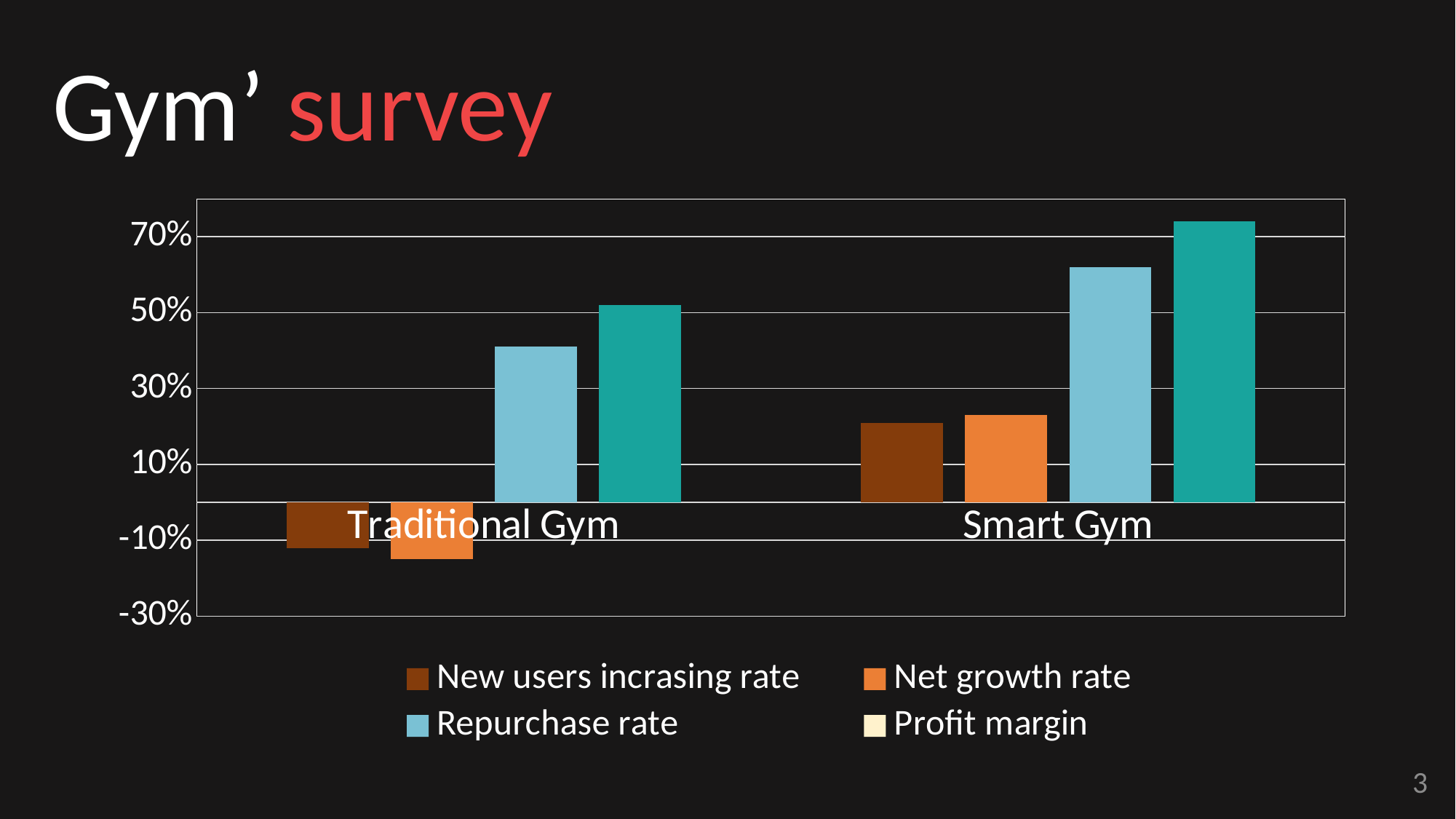
Which category has the highest New users incrasing rate? Smart Gym Is the Net growth rate for Smart Gym greater or less than 10%? greater How many series does the chart's legend list? 4 Is the Repurchase rate for Smart Gym greater or less than 50%? greater Which has the larger Repurchase rate, Traditional Gym or Smart Gym? Smart Gym What kind of chart is shown on the slide? bar chart Is the Repurchase rate for Traditional Gym greater or less than 50%? less What are the four series listed in the chart's legend? New users incrasing rate, Net growth rate, Repurchase rate, Profit margin Which has the larger Net growth rate, Traditional Gym or Smart Gym? Smart Gym How many categories are shown on the x axis of the chart? 2